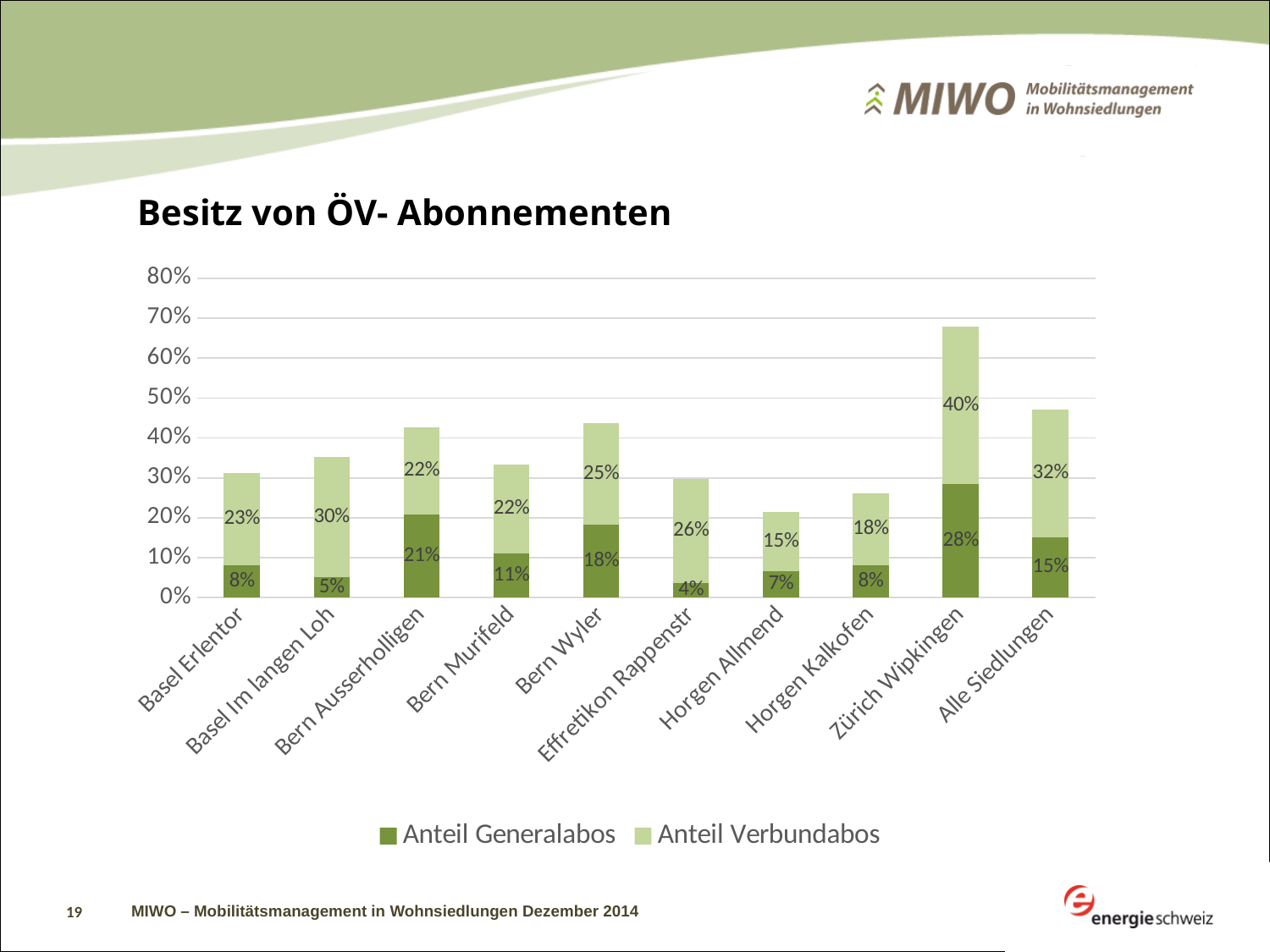
What is the Anteil Verbundabos value for Basel Im langen Loh? 30% Which category has the highest Anteil Verbundabos value? Zürich Wipkingen How many categories are shown on the x axis? 10 What is the Anteil Generalabos value for Effretikon Rappenstr? 4% What is the difference between the Anteil Verbundabos values for Zürich Wipkingen and Horgen Allmend? 25% Which category has the lowest Anteil Generalabos value? Effretikon Rappenstr What type of chart is shown on the slide? stacked bar chart Is the total of the stacked bar for Zürich Wipkingen greater or less than 60%? greater How many series does the legend list? 2 What is the Anteil Generalabos value for Zürich Wipkingen? 28% What is the total of the stacked bar for Alle Siedlungen? 47% Which is larger, the Anteil Generalabos value for Bern Ausserholligen or for Bern Murifeld? Bern Ausserholligen